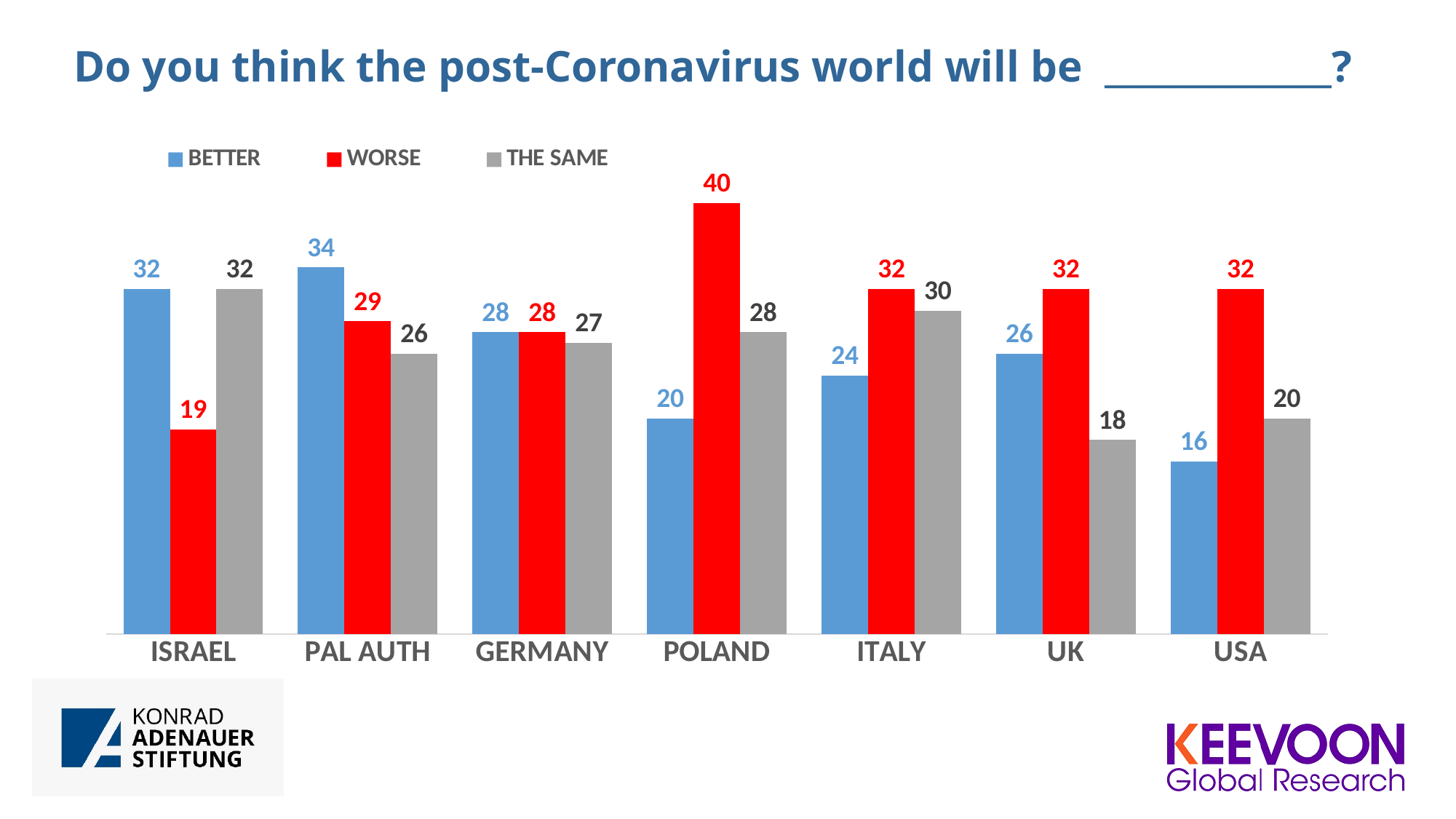
What kind of chart is shown on the slide? bar chart What is the WORSE value for POLAND? 40 How many countries are shown on the x axis? 7 How many series does the legend list? 3 For ISRAEL, which is larger: the BETTER value or the WORSE value? BETTER What is the difference between the WORSE and BETTER values for USA? 16 What is the THE SAME value for UK? 18 What is the difference between the THE SAME values for ITALY and UK? 12 What colour represents the WORSE series? red Which country has the lowest BETTER value? USA What is the BETTER value for PAL AUTH? 34 Which country has the highest WORSE value? POLAND